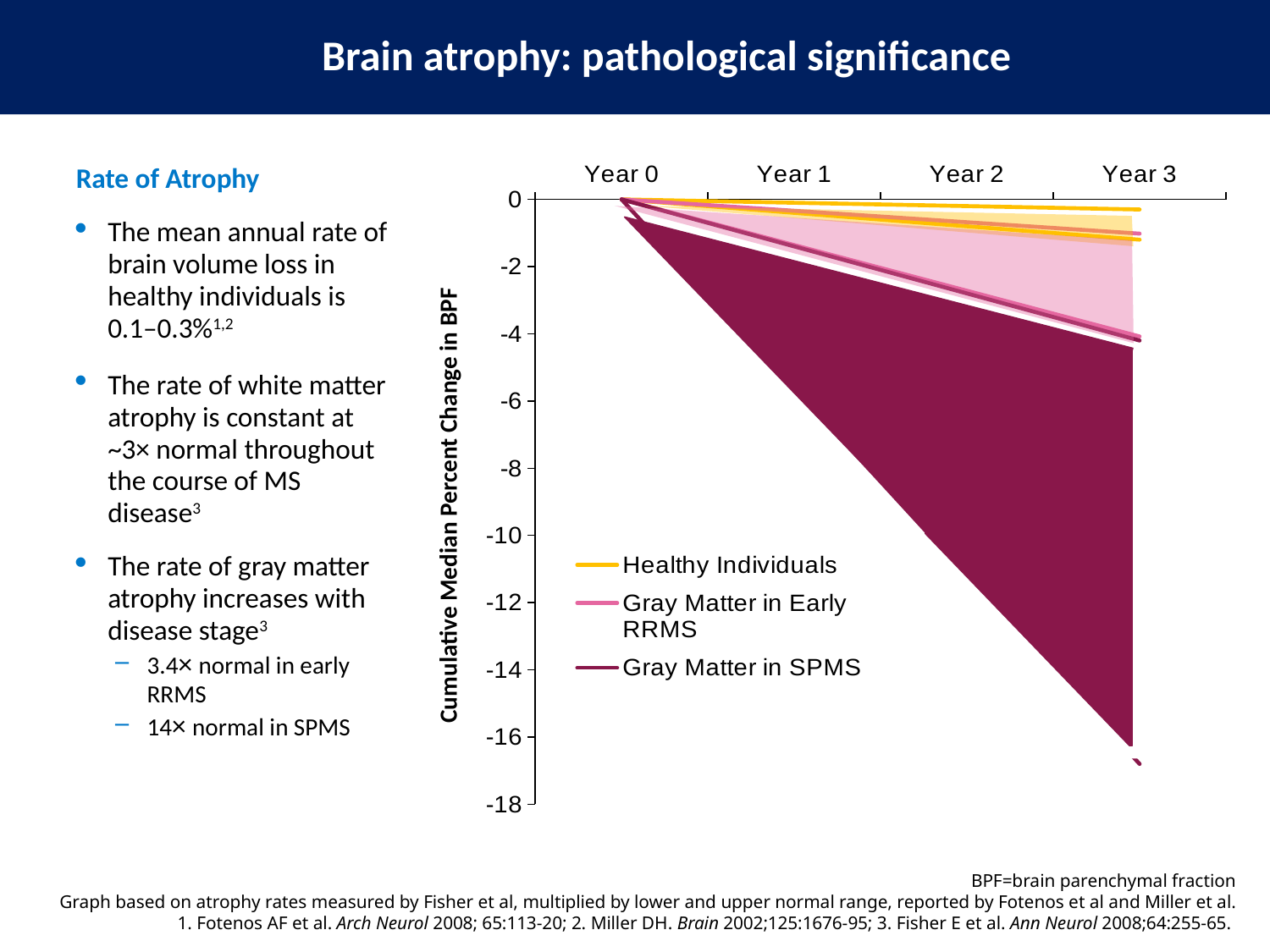
Which series shows the largest cumulative decline in BPF by Year 3? Gray Matter in SPMS Do the values for Gray Matter in SPMS rise or fall from Year 0 to Year 3? Fall Is the lowest value for Gray Matter in Early RRMS at Year 3 greater or less than -6? greater Is the value for Healthy Individuals at Year 3 greater or less than -2? greater What is the label of the y axis of the chart? Cumulative Median Percent Change in BPF What is the lowest value shown on the y axis of the chart? -18 How many year points are labelled on the x axis of the chart? 4 Is the lowest value for Gray Matter in SPMS at Year 3 greater or less than -10? less Which series shows the smallest cumulative decline in BPF by Year 3? Healthy Individuals Which series has a larger decline at Year 3: Gray Matter in Early RRMS or Healthy Individuals? Gray Matter in Early RRMS How many series does the chart legend list? 3 What type of chart is shown on the slide? Line chart